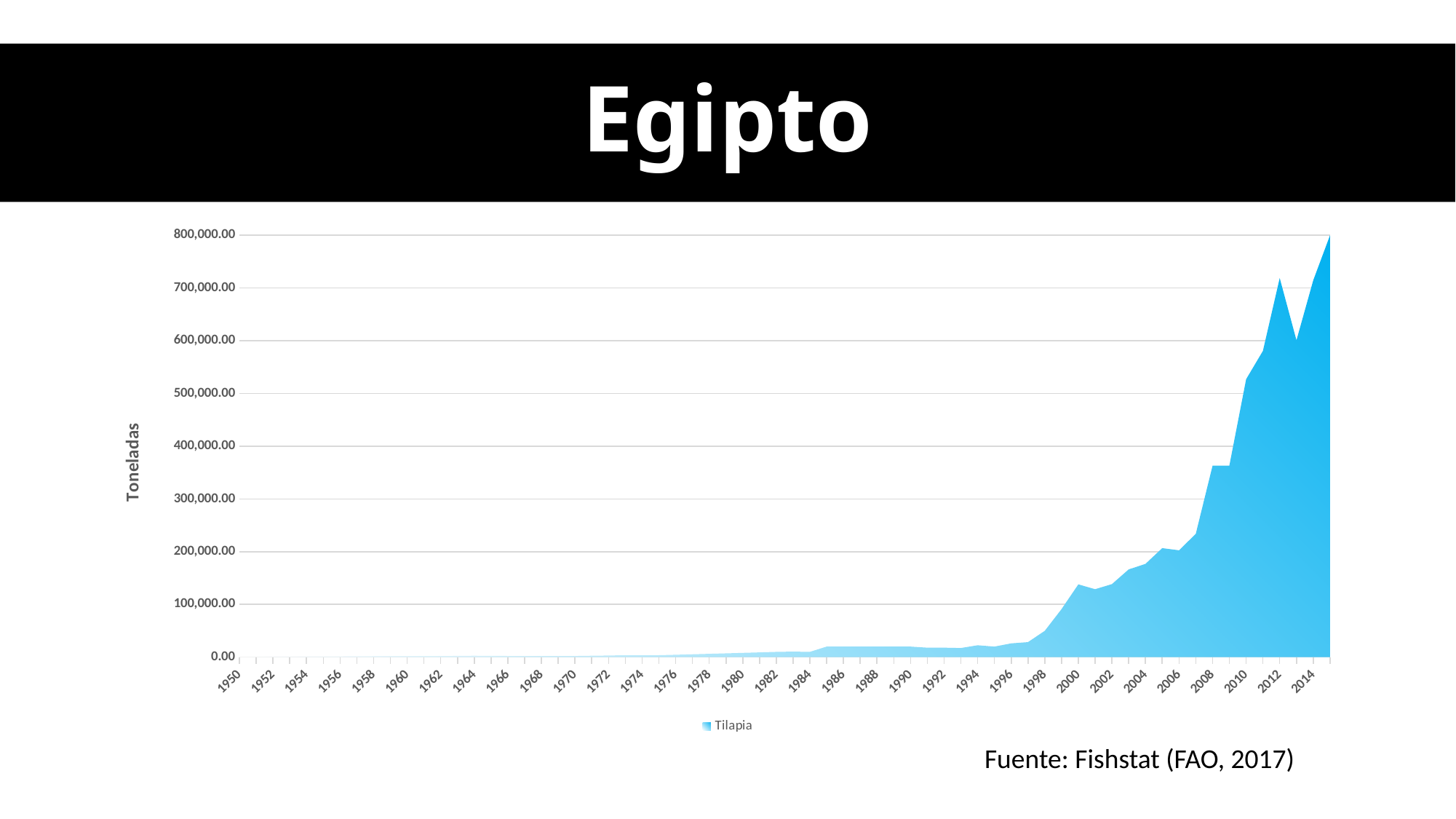
Do the Tilapia values generally rise or fall from 1950 to the end of the x axis? rise Which year has the larger value, 1990 or 2000? 2000 Is the value for 2000 greater or less than 100,000.00? greater Which year has the larger value, 2010 or 2012? 2012 Is the value for 2010 greater or less than 400,000.00? greater Is the value for 2008 greater or less than 300,000.00? greater How many series does the legend list? 1 What kind of chart is shown on the slide? area chart What series name appears in the chart legend? Tilapia What is the title of the vertical axis? Toneladas